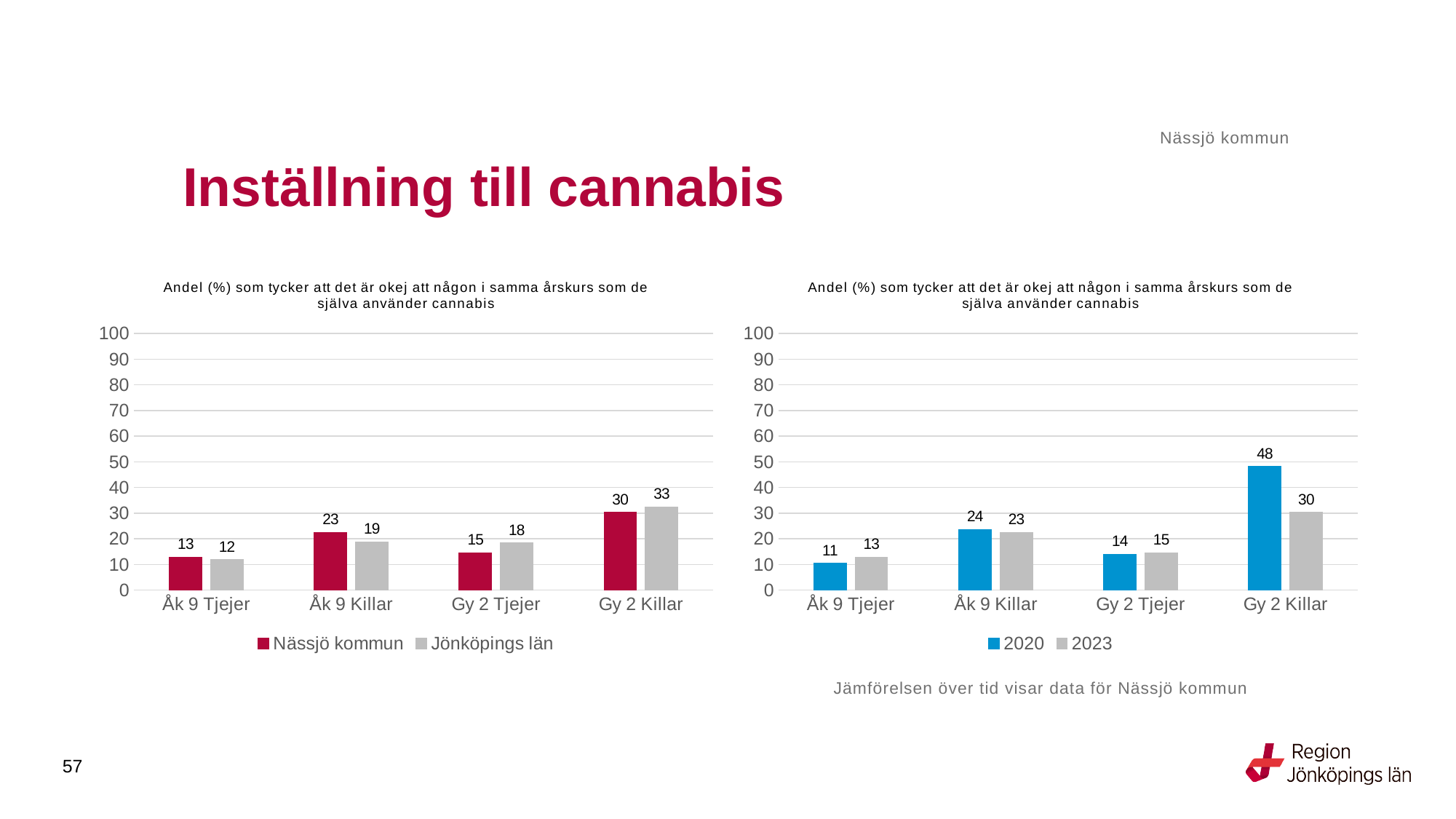
In the right chart, what is the value for 2023 for Åk 9 Tjejer? 13 How many series does the legend of the left chart list? 2 In the left chart, what is the value for Nässjö kommun for Åk 9 Killar? 23 In the left chart, which is larger for Gy 2 Tjejer: Nässjö kommun or Jönköpings län? Jönköpings län What kind of chart is the right chart? Bar chart In the left chart, what is the value for Jönköpings län for Gy 2 Killar? 33 In the right chart, which category has the lowest value for 2020? Åk 9 Tjejer In the right chart, what is the value for 2020 for Gy 2 Killar? 48 In the left chart, which category has the highest value for Nässjö kommun? Gy 2 Killar How many categories are shown on the x axis of the right chart? 4 In the right chart, what is the difference between the 2020 and 2023 values for Gy 2 Killar? 18 In the left chart, what is the difference between the Jönköpings län and Nässjö kommun values for Åk 9 Killar? 4